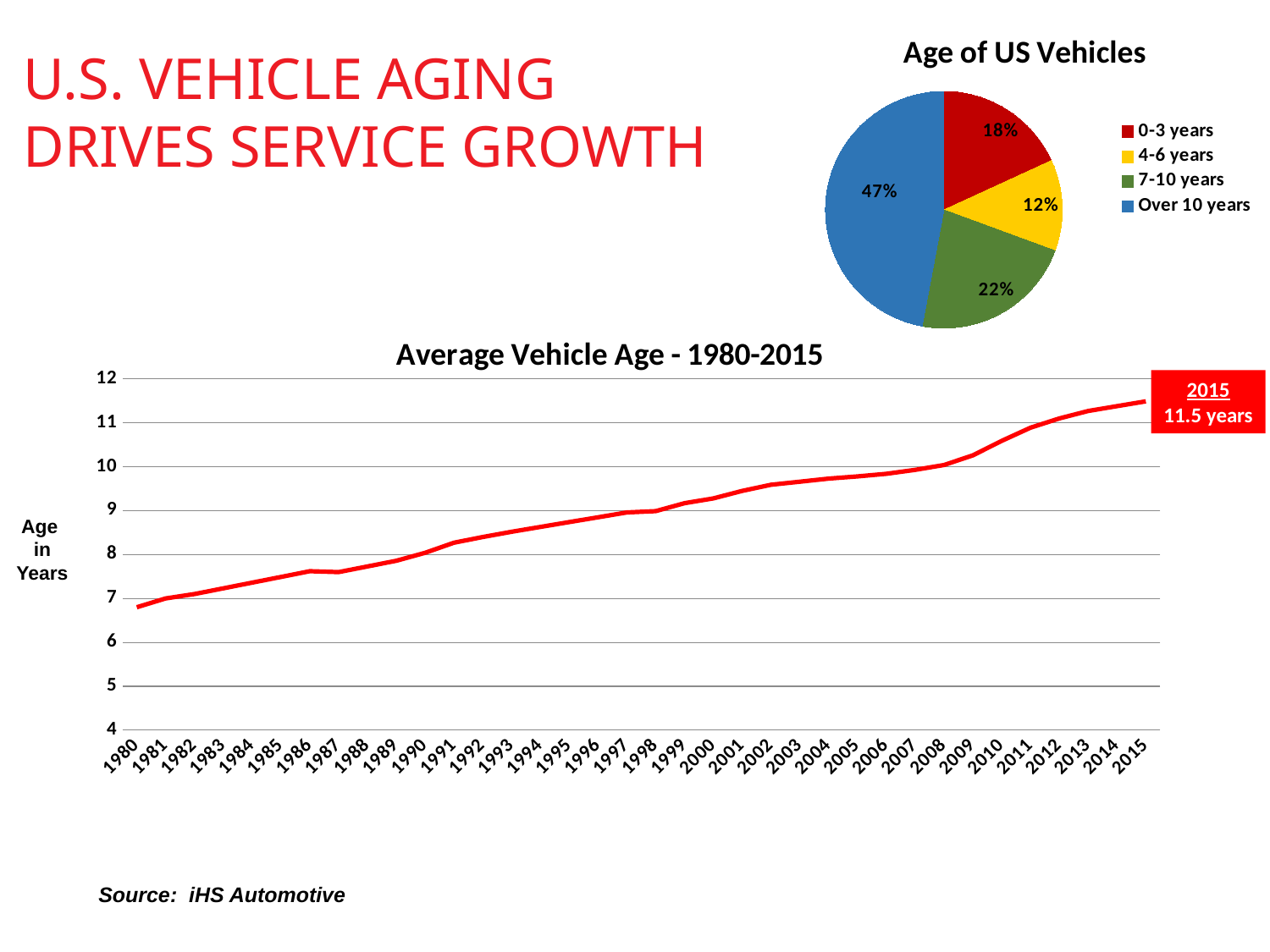
In the 'Age of US Vehicles' pie chart, which age group has the largest share? Over 10 years In the 'Average Vehicle Age - 1980-2015' chart, what is the average vehicle age in 2015? 11.5 years In the 'Average Vehicle Age - 1980-2015' chart, is the value for 1980 greater or less than 7? less In the 'Average Vehicle Age - 1980-2015' chart, does the average vehicle age rise or fall from 1980 to 2015? Rises In the 'Age of US Vehicles' pie chart, what share of vehicles are over 10 years old? 47% In the 'Average Vehicle Age - 1980-2015' chart, is the value for 2010 greater or less than 10? greater In the 'Age of US Vehicles' pie chart, what share of vehicles are 0-3 years old? 18% In the 'Age of US Vehicles' pie chart, what share of vehicles are 4-6 years old? 12% In the 'Age of US Vehicles' pie chart, which age group has the smallest share? 4-6 years In the 'Age of US Vehicles' pie chart, what is the difference between the share of vehicles over 10 years old and the share 7-10 years old? 25% What kind of chart is 'Age of US Vehicles'? Pie chart In the 'Age of US Vehicles' pie chart, how many age groups does the legend list? 4